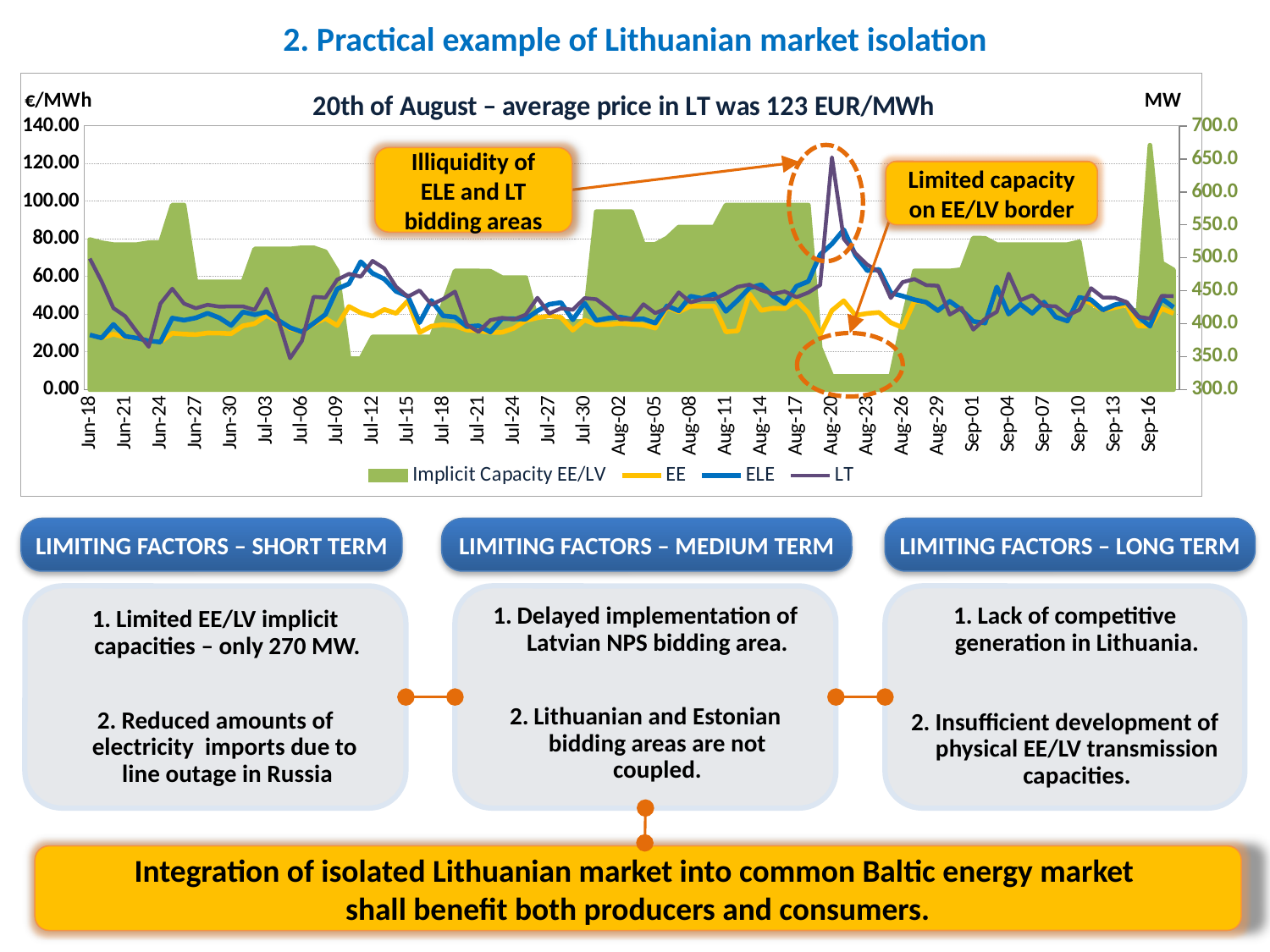
How many series does the chart legend list? 4 On which date does the LT series reach its highest value? Aug-20 Which series has the highest value on Aug-20? LT Which series in the legend is drawn as a shaded green area rather than a line? Implicit Capacity EE/LV On Jun-18, which is higher, the LT series or the ELE series? LT Is the Implicit Capacity EE/LV value on Aug-23 greater or less than 350 MW? less According to the chart title, what was the average price in LT on the 20th of August? 123 EUR/MWh Is the Implicit Capacity EE/LV value at its peak around Sep-16 greater or less than 600 MW? greater Is the LT value on Aug-20 greater or less than 100 €/MWh? greater What is the title of the chart? 20th of August – average price in LT was 123 EUR/MWh What kind of chart is shown on the slide? Combination area and line chart